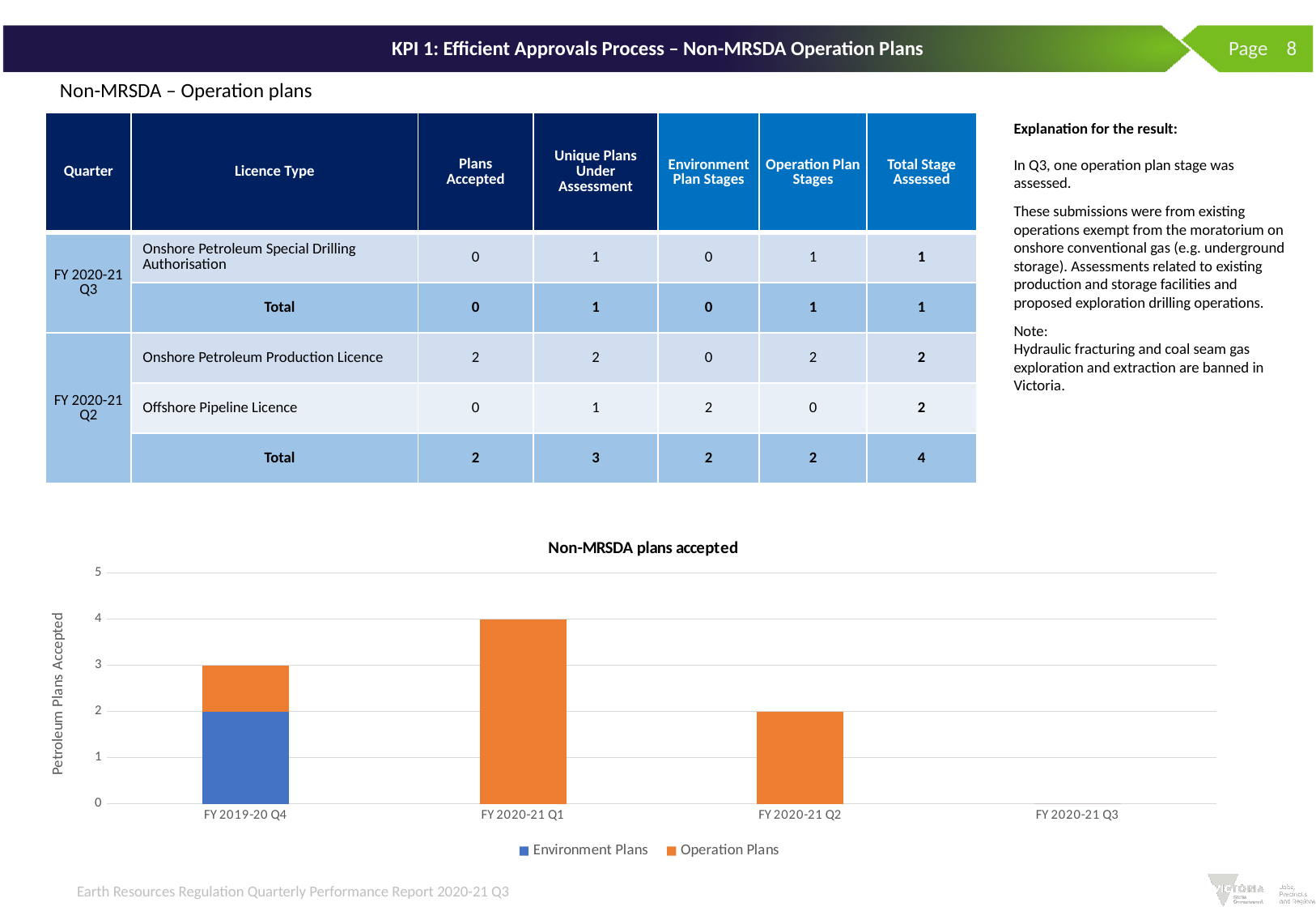
In the 'Non-MRSDA plans accepted' chart, is the total for FY 2020-21 Q2 greater or less than 3? less In the 'Non-MRSDA plans accepted' chart, which quarter has the tallest bar? FY 2020-21 Q1 How many quarters are shown on the x axis of the 'Non-MRSDA plans accepted' chart? 4 In the 'Non-MRSDA plans accepted' chart, what is the value of Operation Plans for FY 2020-21 Q1? 4 In the 'Non-MRSDA plans accepted' chart, which bar is taller: FY 2020-21 Q1 or FY 2020-21 Q2? FY 2020-21 Q1 In the 'Non-MRSDA plans accepted' chart, what is the total height of the stacked bar for FY 2019-20 Q4? 3 How many series does the legend of the 'Non-MRSDA plans accepted' chart list? 2 In the 'Non-MRSDA plans accepted' chart, what is the value of Operation Plans for FY 2020-21 Q2? 2 What kind of chart is shown under the title 'Non-MRSDA plans accepted'? Stacked bar chart In the 'Non-MRSDA plans accepted' chart, what is the value of Environment Plans for FY 2019-20 Q4? 2 In the 'Non-MRSDA plans accepted' chart, which quarter has no bar plotted at all? FY 2020-21 Q3 In the 'Non-MRSDA plans accepted' chart, what colour represents Operation Plans in the legend? Orange